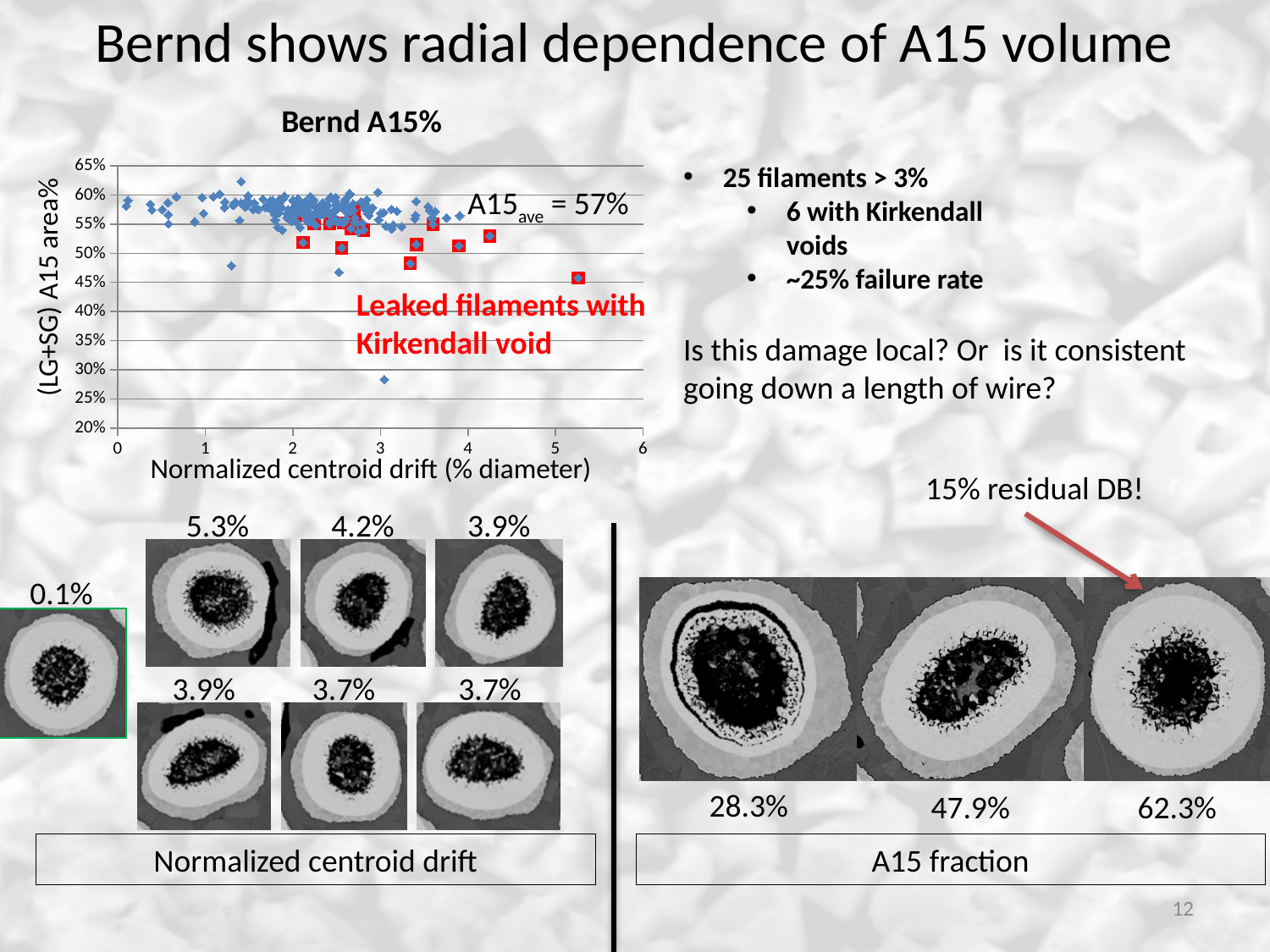
Do the A15 area% values generally rise or fall as normalized centroid drift increases along the x axis? fall What do the red-outlined points on the chart represent, according to the red annotation? Leaked filaments with Kirkendall void What is the highest value shown on the y axis of the chart? 65% What is the highest value shown on the x axis of the chart? 6 Is the A15 area% of the point near a centroid drift of 1.3 that lies below the main cluster greater or less than 50%? less Is the A15 area% of the rightmost red-outlined point (near a centroid drift of 5.3) greater or less than 40%? greater Is the lowest plotted point on the chart (near a centroid drift of 3) greater or less than 25% A15 area? greater What kind of chart is shown under the title "Bernd A15%"? scatter chart What is the title of the chart on the slide? Bernd A15% According to the annotation on the chart, what is the average A15 value (A15ave)? 57%